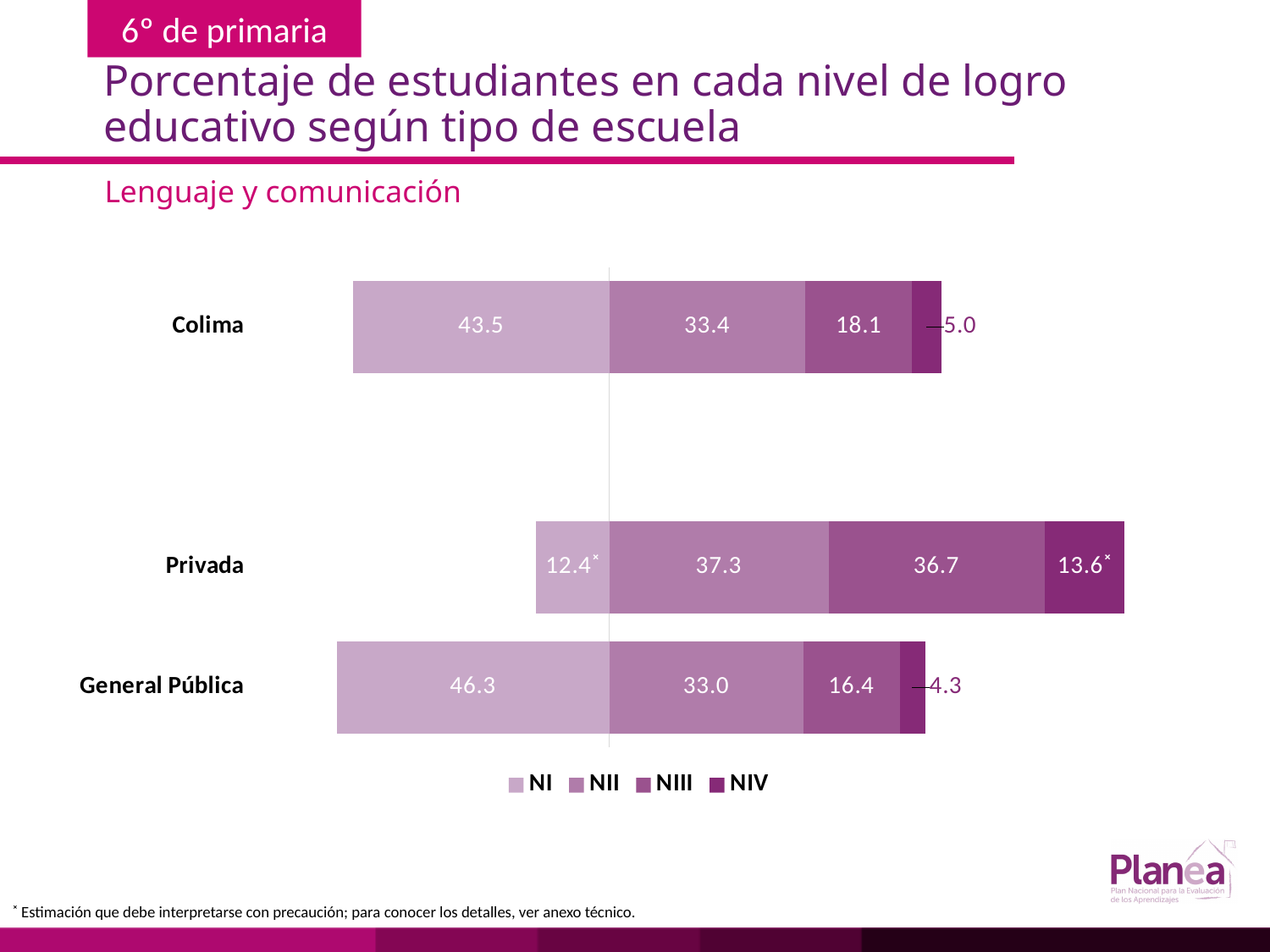
What kind of chart is shown on the slide? Stacked bar chart What is the difference between the NIII values for Colima and General Pública? 1.7 Which school type has the highest NI value? General Pública What is the NIV value for General Pública? 4.3 Which school type has the lowest NIV value? General Pública Which is larger, the NII value for Privada or the NII value for Colima? Privada What is the total of the stacked bar for Privada? 100.0 What percentage of Colima students are at level NI? 43.5 What is the NIII value for Privada schools? 36.7 How many school types (categories) are shown in the chart? 3 How many series does the legend list? 4 What is the NII value for General Pública? 33.0